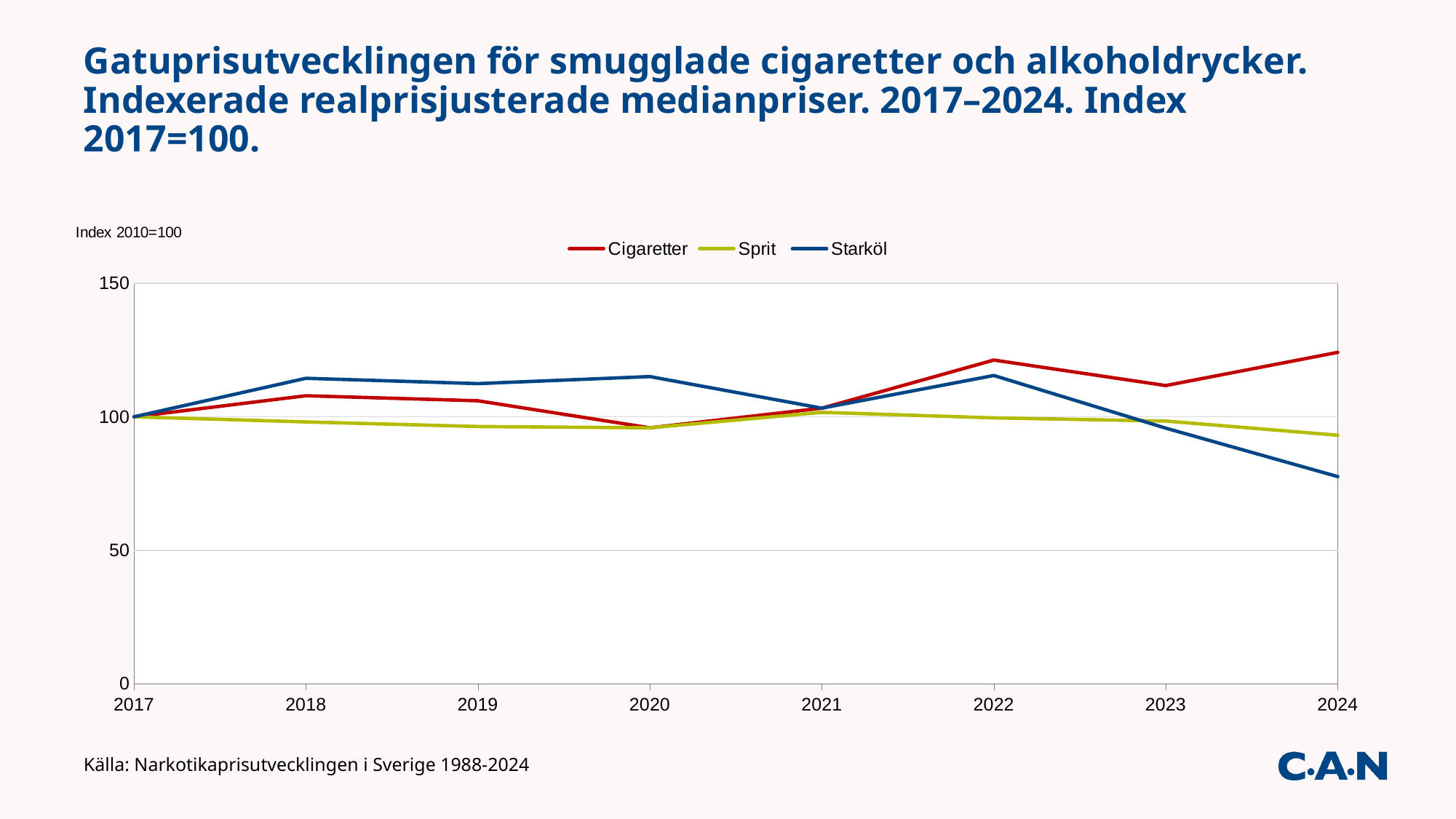
Which series is drawn in red? Cigaretter How many years are shown along the x axis? 8 Does the Starköl line rise or fall from 2022 to 2024? fall What is the index value for Cigaretter in 2017? 100 Which series has the lowest value in 2024? Starköl Is the value for Cigaretter in 2024 greater or less than 100? greater How many series does the legend list? 3 Is the value for Starköl in 2024 greater or less than 100? less What kind of chart is shown on the slide? line chart Is the value for Starköl in 2018 greater or less than 100? greater Which series has the highest value in 2024? Cigaretter Which series has the highest value in 2020? Starköl